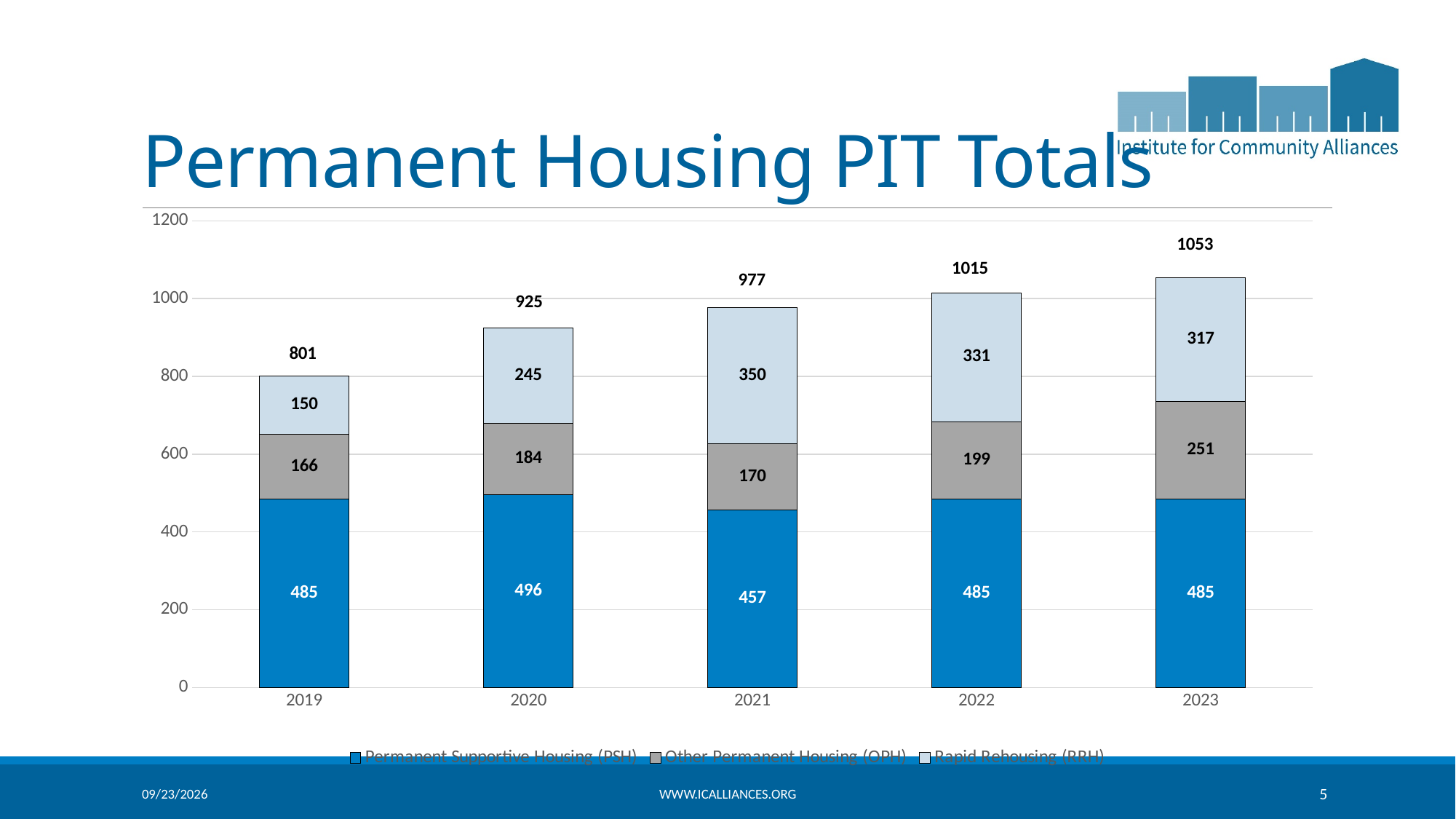
Which is larger, the Other Permanent Housing (OPH) value for 2023 or for 2020? 2023 Which year has the highest total Permanent Housing PIT count? 2023 What is the difference between the total for 2023 and the total for 2019? 252 Which year has the lowest Rapid Rehousing (RRH) value? 2019 How many years are shown on the x axis? 5 What kind of chart is shown on the slide? Stacked bar chart Do the total Permanent Housing PIT counts rise or fall from 2019 to 2023? Rise What is the Permanent Supportive Housing (PSH) value for 2021? 457 What is the total Permanent Housing PIT count for 2023? 1053 What is the Other Permanent Housing (OPH) value for 2022? 199 What is the Rapid Rehousing (RRH) value for 2019? 150 How many series does the legend list? 3